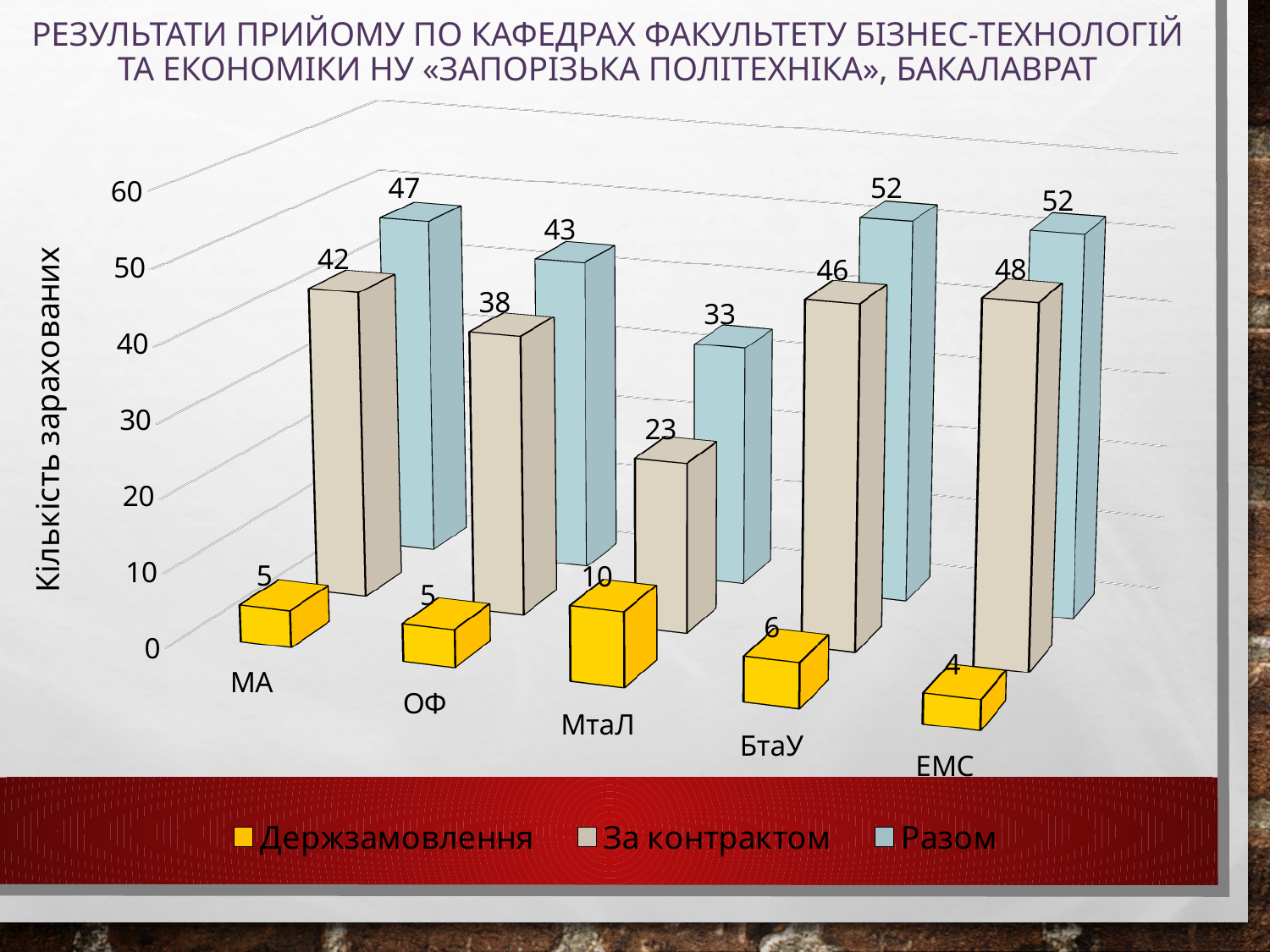
What kind of chart is shown on the slide? bar chart What is the label of the vertical axis? Кількість зарахованих What is the value of За контрактом for МтаЛ? 23 What is the difference between the Разом values for БтаУ and МтаЛ? 19 Which is larger: За контрактом for ЕМС or За контрактом for МА? ЕМС What is the value of Разом for ОФ? 43 Which category has the lowest value for Разом? МтаЛ How many series does the legend list? 3 How many categories are shown on the x axis? 5 Which category has the highest value for Держзамовлення? МтаЛ Which category has the lowest value for За контрактом? МтаЛ What is the value of Держзамовлення for ЕМС? 4